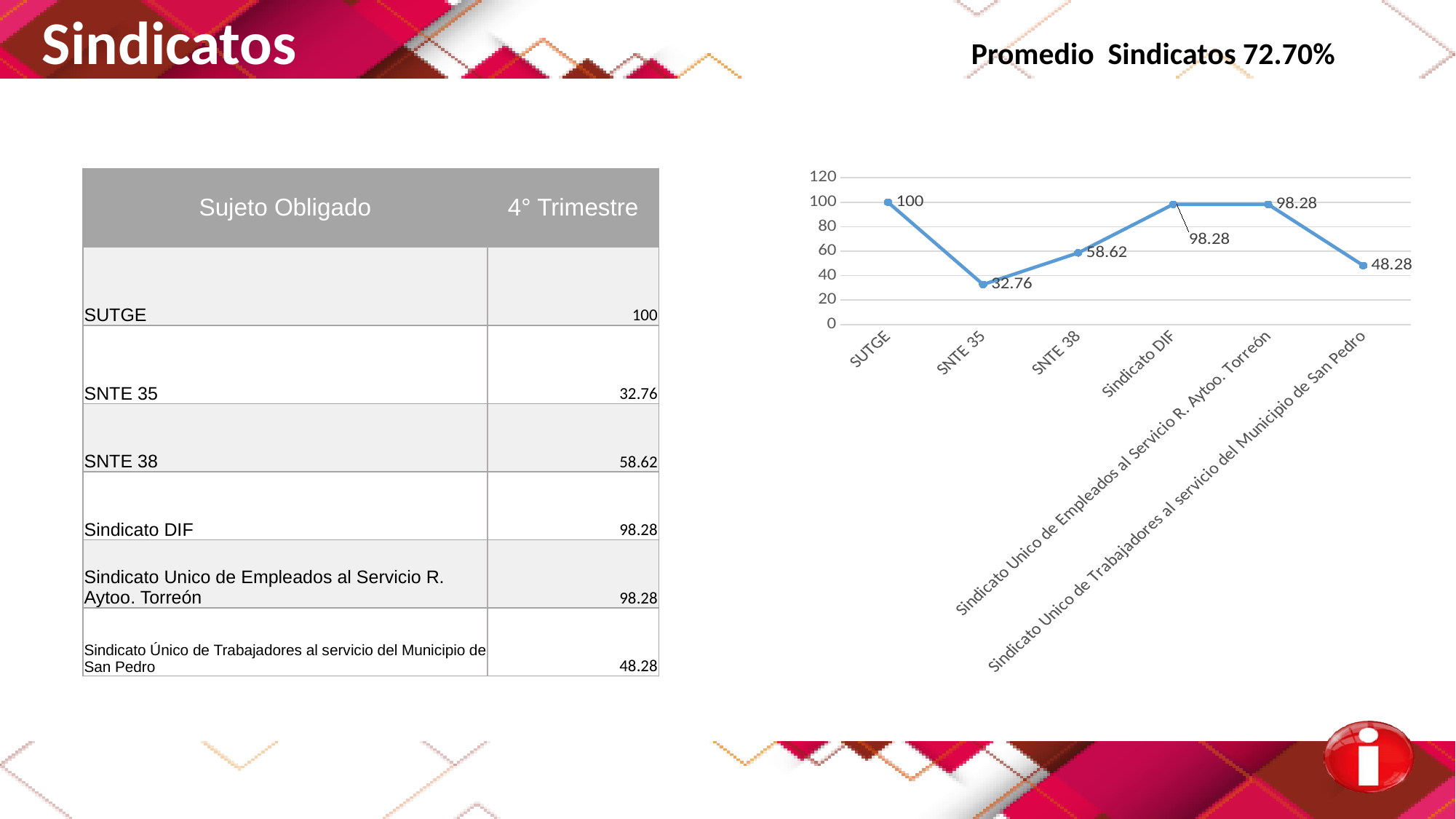
What is the value for SNTE 35? 32.76 Which category has the highest value? SUTGE What is the difference between the values for SUTGE and SNTE 35? 67.24 Which is larger, the value for SNTE 38 or the value for Sindicato DIF? Sindicato DIF How many categories are plotted on the x axis? 6 What kind of chart is shown on the slide? line chart Does the line rise or fall between Sindicato Unico de Empleados al Servicio R. Aytoo. Torreón and Sindicato Único de Trabajadores al servicio del Municipio de San Pedro? fall What is the value for SUTGE? 100 Which category has the lowest value? SNTE 35 What is the value for SNTE 38? 58.62 Is the value for SNTE 35 greater or less than 40? less What is the value for Sindicato Único de Trabajadores al servicio del Municipio de San Pedro? 48.28